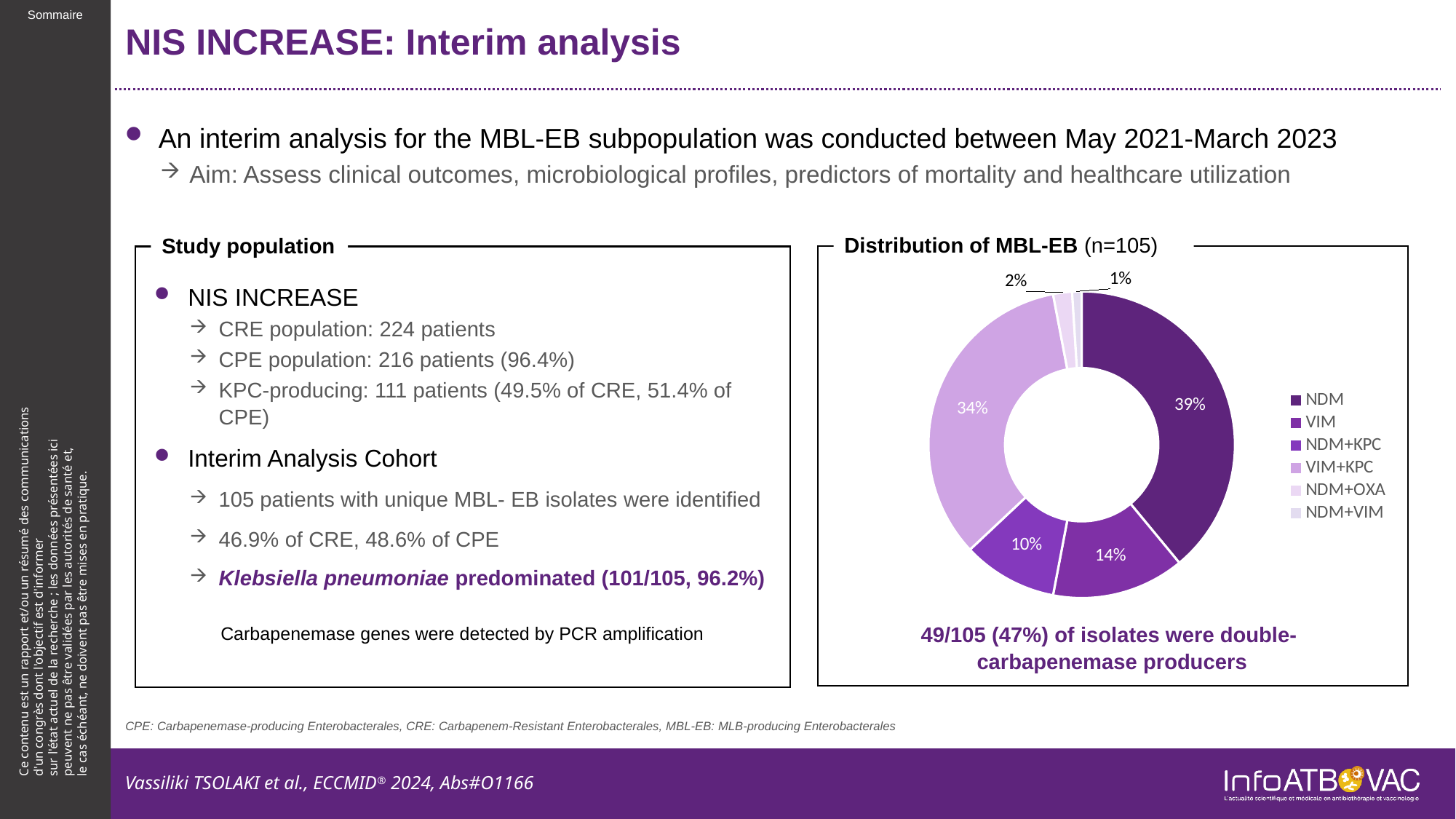
What is the value shown for VIM in the Distribution of MBL-EB chart? 14% What percentage does the VIM+KPC slice represent in the Distribution of MBL-EB chart? 34% What percentage is labelled for NDM+KPC in the doughnut chart? 10% What is the sample size stated in the title of the Distribution of MBL-EB chart? n=105 What type of chart is used to show the Distribution of MBL-EB? Doughnut (pie) chart In the Distribution of MBL-EB chart, which is larger: VIM or NDM+KPC? VIM In the Distribution of MBL-EB chart, how many percentage points larger is NDM than VIM+KPC? 5% How many categories does the legend of the Distribution of MBL-EB chart list? 6 What share does NDM+OXA account for in the Distribution of MBL-EB chart? 2% Which category has the smallest slice in the Distribution of MBL-EB chart? NDM+VIM What share of the MBL-EB distribution chart is NDM? 39% Which category has the largest slice in the Distribution of MBL-EB chart? NDM